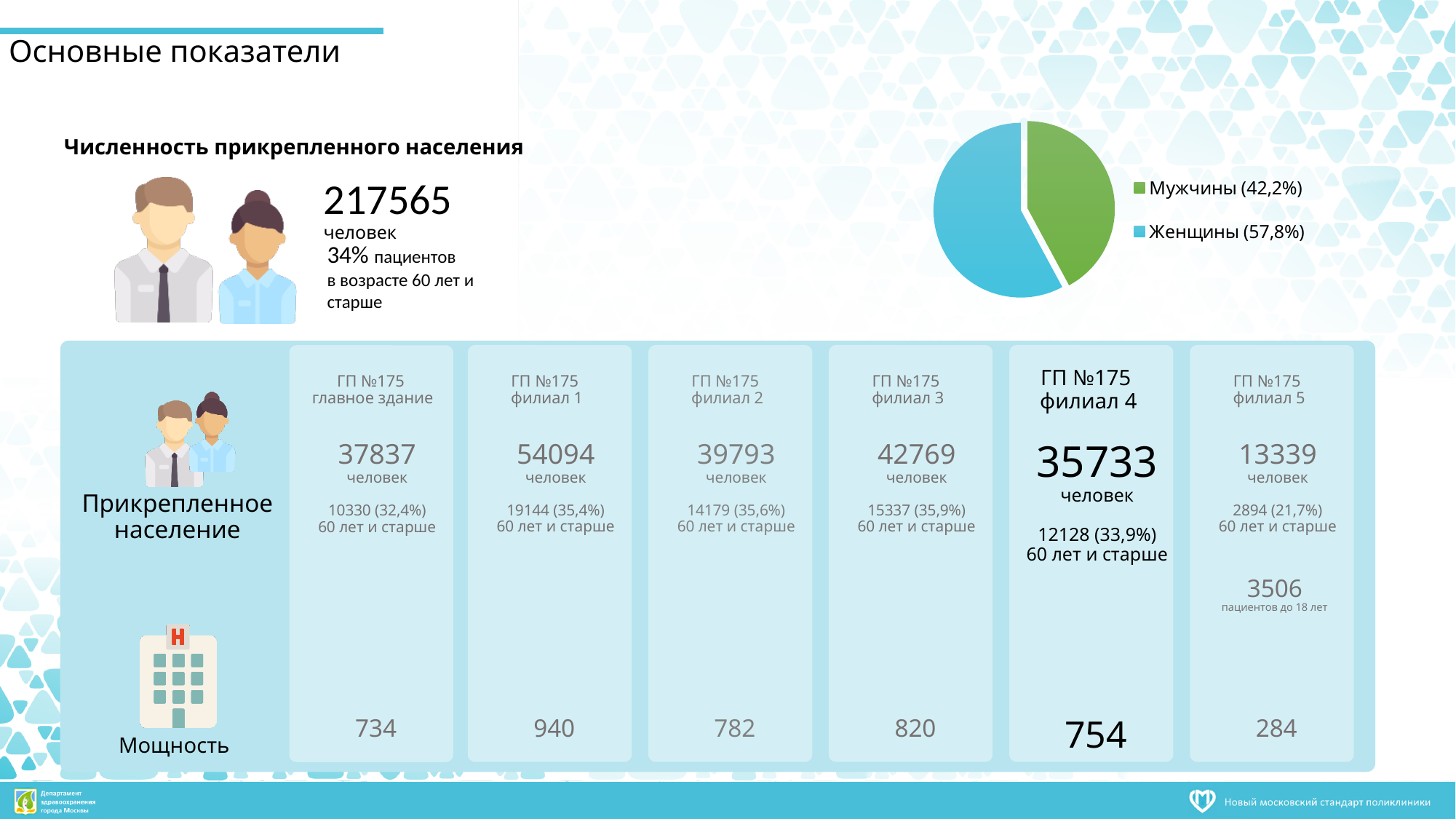
How many entries does the legend of the pie chart list? 2 In the pie chart, which is larger: Мужчины or Женщины? Женщины What kind of chart is shown on the slide? pie chart What share of the pie chart is Мужчины? 42,2% What colour is the Женщины slice in the pie chart? blue Which slice of the pie chart is the smallest? Мужчины What share of the pie chart is Женщины? 57,8% Which slice of the pie chart is the largest? Женщины Is the share for Женщины in the pie chart greater or less than 50%? greater How many slices does the pie chart have? 2 By how many percentage points does the Женщины share exceed the Мужчины share in the pie chart? 15,6 What colour is the Мужчины slice in the pie chart? green